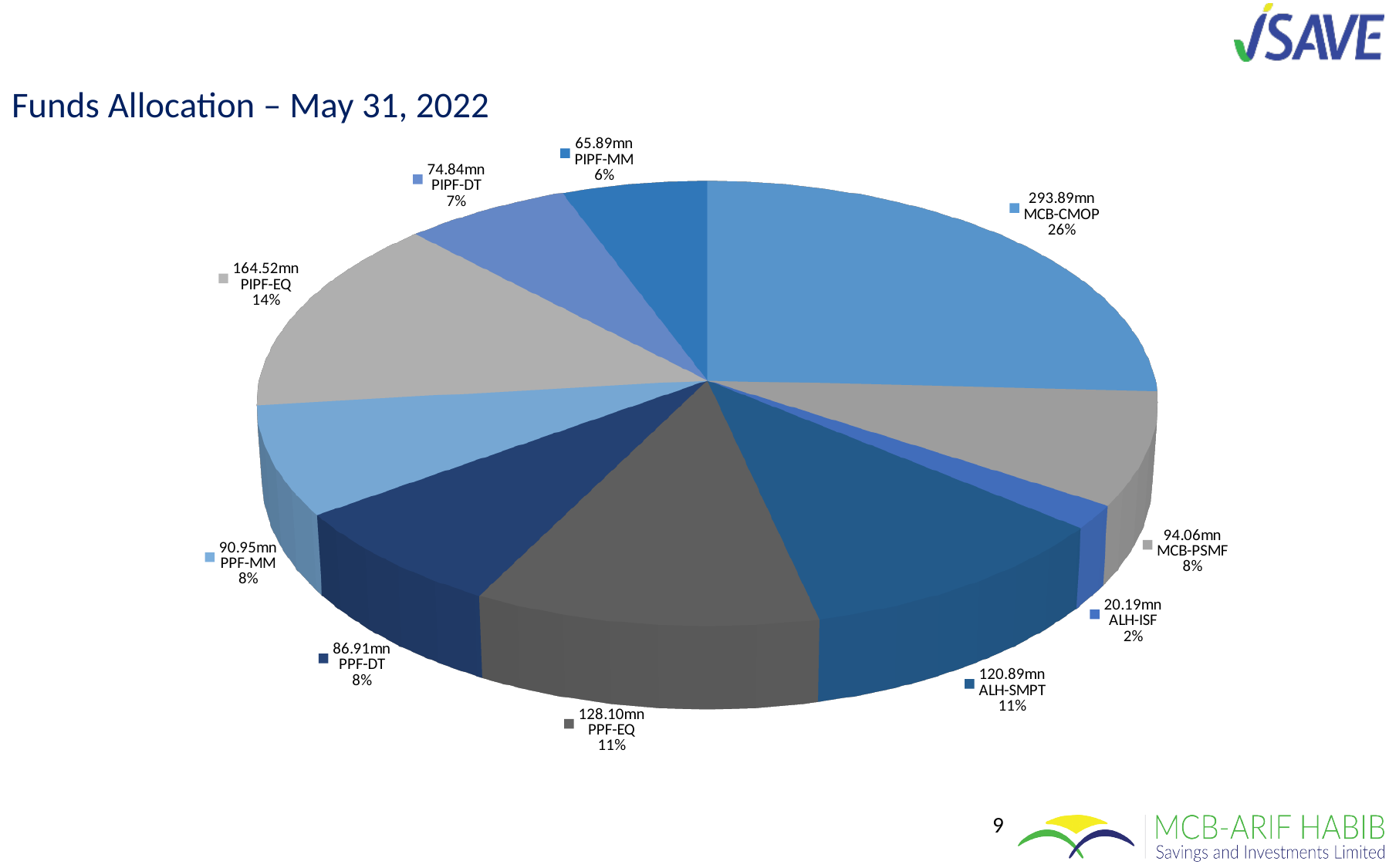
Which fund has the largest slice of the pie? MCB-CMOP What is the difference between the values for MCB-CMOP and PIPF-EQ? 129.37mn Which fund has the smallest slice of the pie? ALH-ISF How many slices does the pie chart have? 10 What share of the pie does MCB-CMOP represent? 26% What is the title of the chart? Funds Allocation – May 31, 2022 Which is larger, the value for ALH-SMPT or the value for MCB-PSMF? ALH-SMPT What is the value for PIPF-EQ? 164.52mn What kind of chart is shown on the slide? Pie chart What is the value for MCB-CMOP? 293.89mn What share of the pie does PPF-MM represent? 8% What is the value for ALH-ISF? 20.19mn